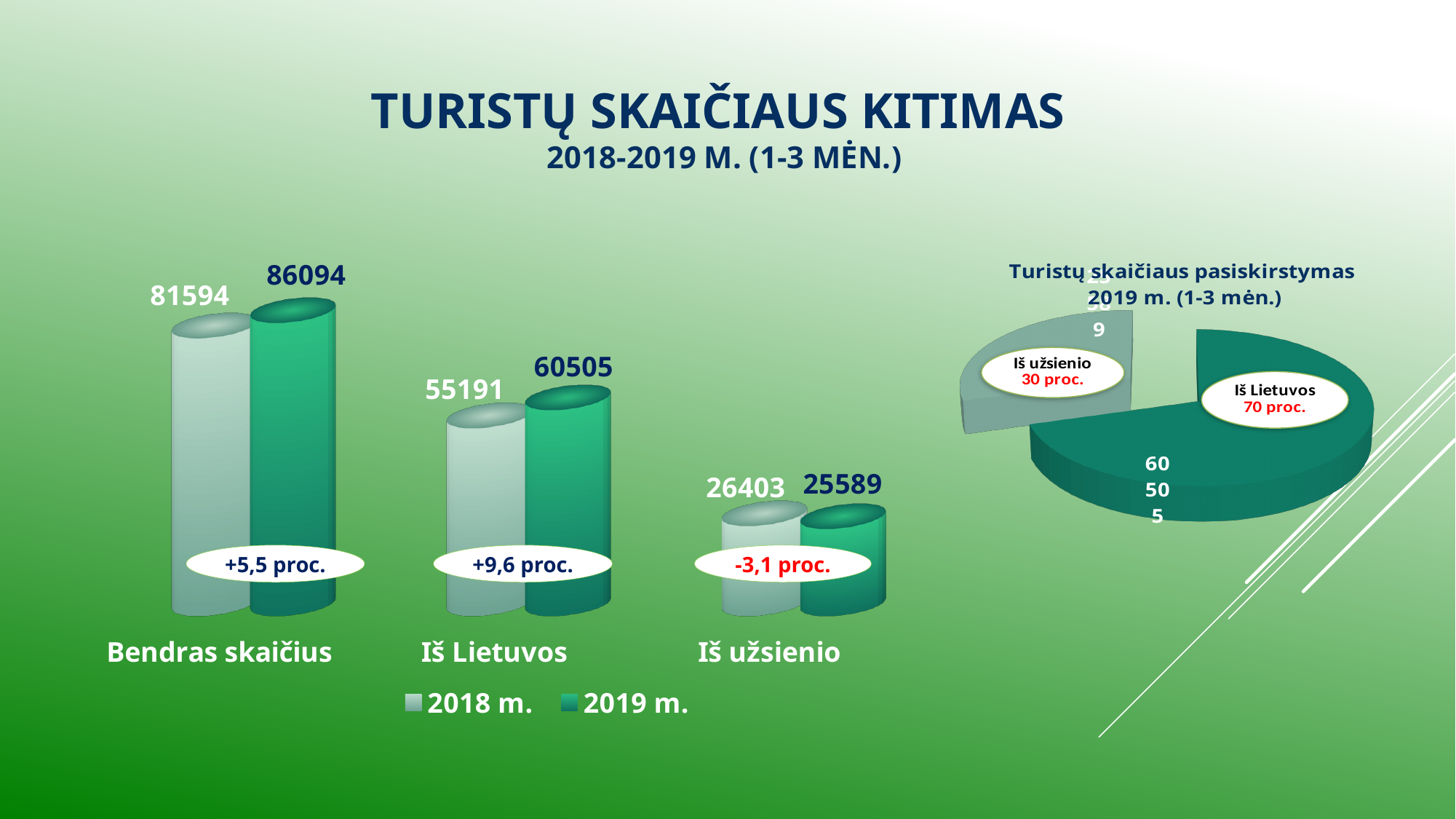
What kind of chart is the chart on the right of the slide? Pie chart In the bar chart on the left, what is the value for Iš užsienio in 2019 m.? 25589 In the bar chart on the left, how many series does the legend list? 2 In the bar chart on the left, what is the value for Bendras skaičius in 2019 m.? 86094 In the bar chart on the left, which category has the lowest value in 2018 m.? Iš užsienio In the bar chart on the left, which is larger for Iš užsienio: the 2018 m. value or the 2019 m. value? 2018 m. In the pie chart on the right, what share is shown for Iš Lietuvos? 70 proc. In the bar chart on the left, what percentage change is shown for Iš Lietuvos? +9,6 proc. In the bar chart on the left, what is the difference between the 2019 m. and 2018 m. values for Bendras skaičius? 4500 In the bar chart on the left, what is the value for Iš Lietuvos in 2018 m.? 55191 In the bar chart on the left, how many categories are shown on the x axis? 3 In the pie chart on the right, what share is shown for Iš užsienio? 30 proc.